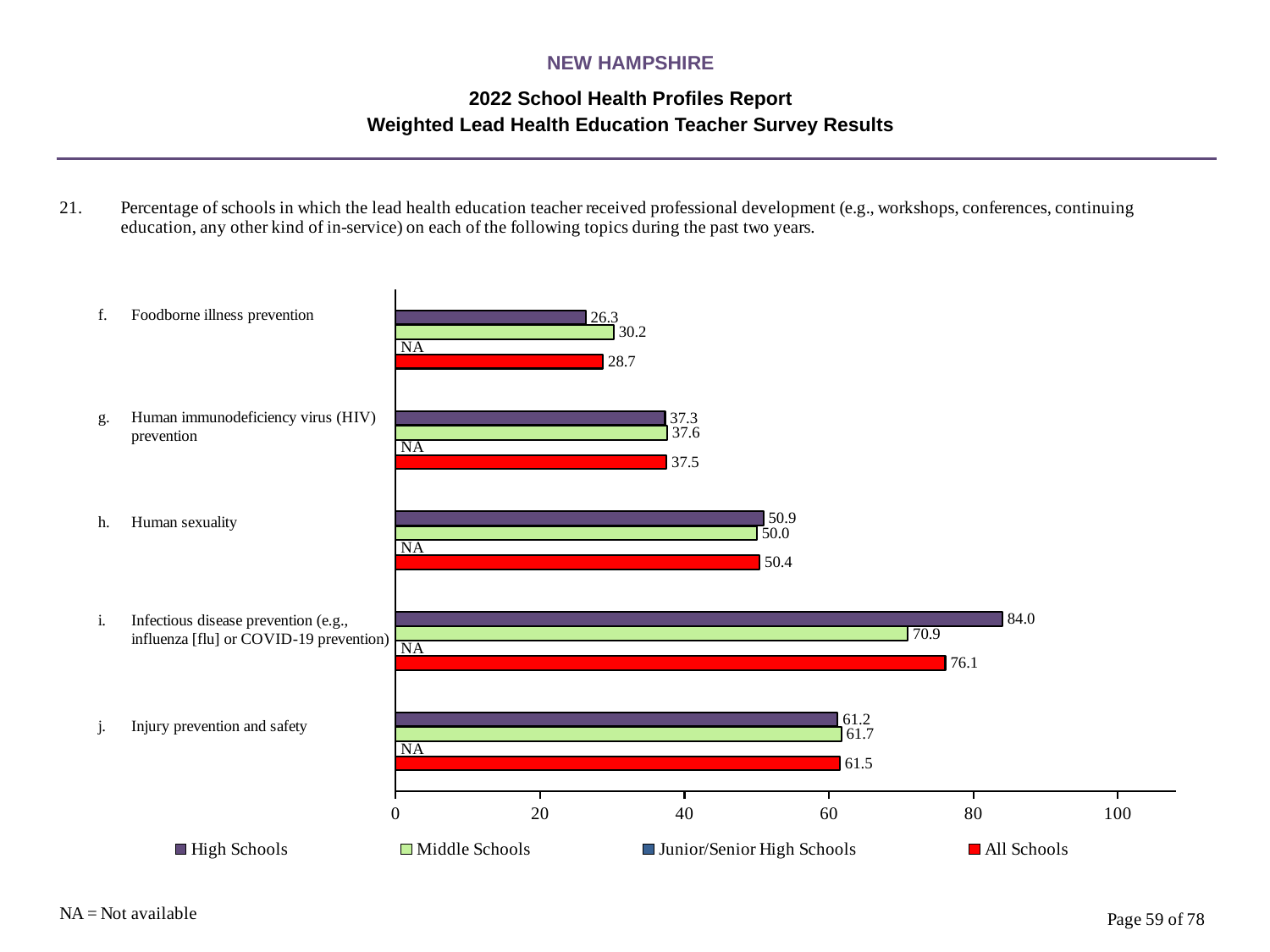
How many series does the legend list? 4 Which topic has the lowest value for High Schools? Foodborne illness prevention What is the value for All Schools for Human sexuality? 50.4 What is the value for Junior/Senior High Schools for Injury prevention and safety? NA What kind of chart is shown on the slide? Bar chart What is the difference between the High Schools and Middle Schools values for Infectious disease prevention? 13.1 What is the value for High Schools for Infectious disease prevention (e.g., influenza [flu] or COVID-19 prevention)? 84.0 What is the value for Middle Schools for Foodborne illness prevention? 30.2 How many topics are shown on the chart? 5 Which is larger for Foodborne illness prevention: the High Schools value or the Middle Schools value? Middle Schools What colour are the All Schools bars? Red Which topic has the highest value for All Schools? Infectious disease prevention (e.g., influenza [flu] or COVID-19 prevention)